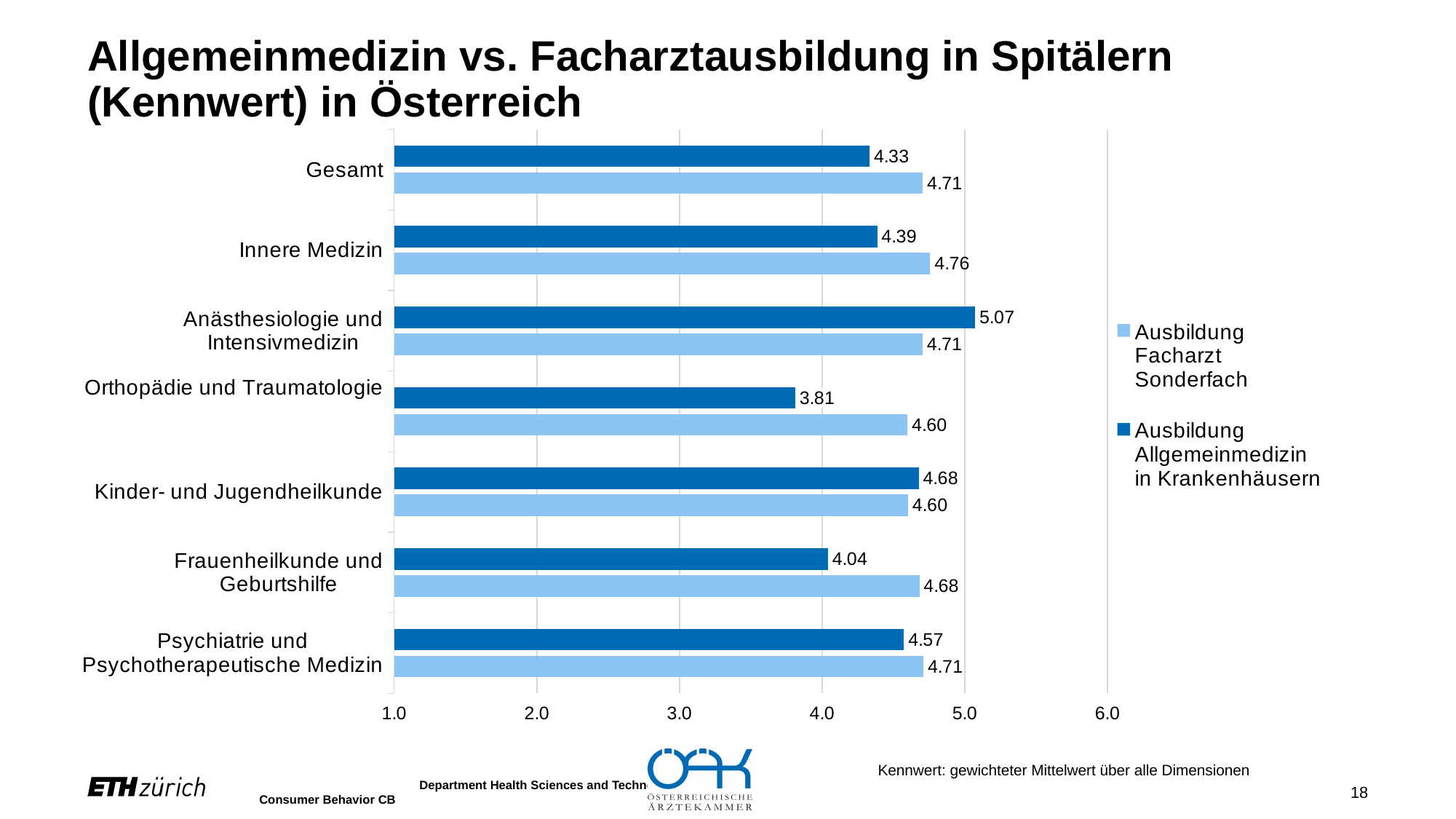
What is the value for Ausbildung Allgemeinmedizin in Krankenhäusern for Gesamt? 4.33 What is the value for Ausbildung Allgemeinmedizin in Krankenhäusern for Anästhesiologie und Intensivmedizin? 5.07 Which category has the highest value for Ausbildung Allgemeinmedizin in Krankenhäusern? Anästhesiologie und Intensivmedizin For Frauenheilkunde und Geburtshilfe, which series has the larger value: Ausbildung Facharzt Sonderfach or Ausbildung Allgemeinmedizin in Krankenhäusern? Ausbildung Facharzt Sonderfach Which category has the highest value for Ausbildung Facharzt Sonderfach? Innere Medizin What is the value for Ausbildung Facharzt Sonderfach for Frauenheilkunde und Geburtshilfe? 4.68 How many categories are shown on the chart? 7 Which category has the lowest value for Ausbildung Allgemeinmedizin in Krankenhäusern? Orthopädie und Traumatologie What is the value for Ausbildung Facharzt Sonderfach for Innere Medizin? 4.76 What is the difference between the Ausbildung Facharzt Sonderfach and Ausbildung Allgemeinmedizin in Krankenhäusern values for Orthopädie und Traumatologie? 0.79 What kind of chart is shown on the slide? Bar chart How many series does the legend list? 2